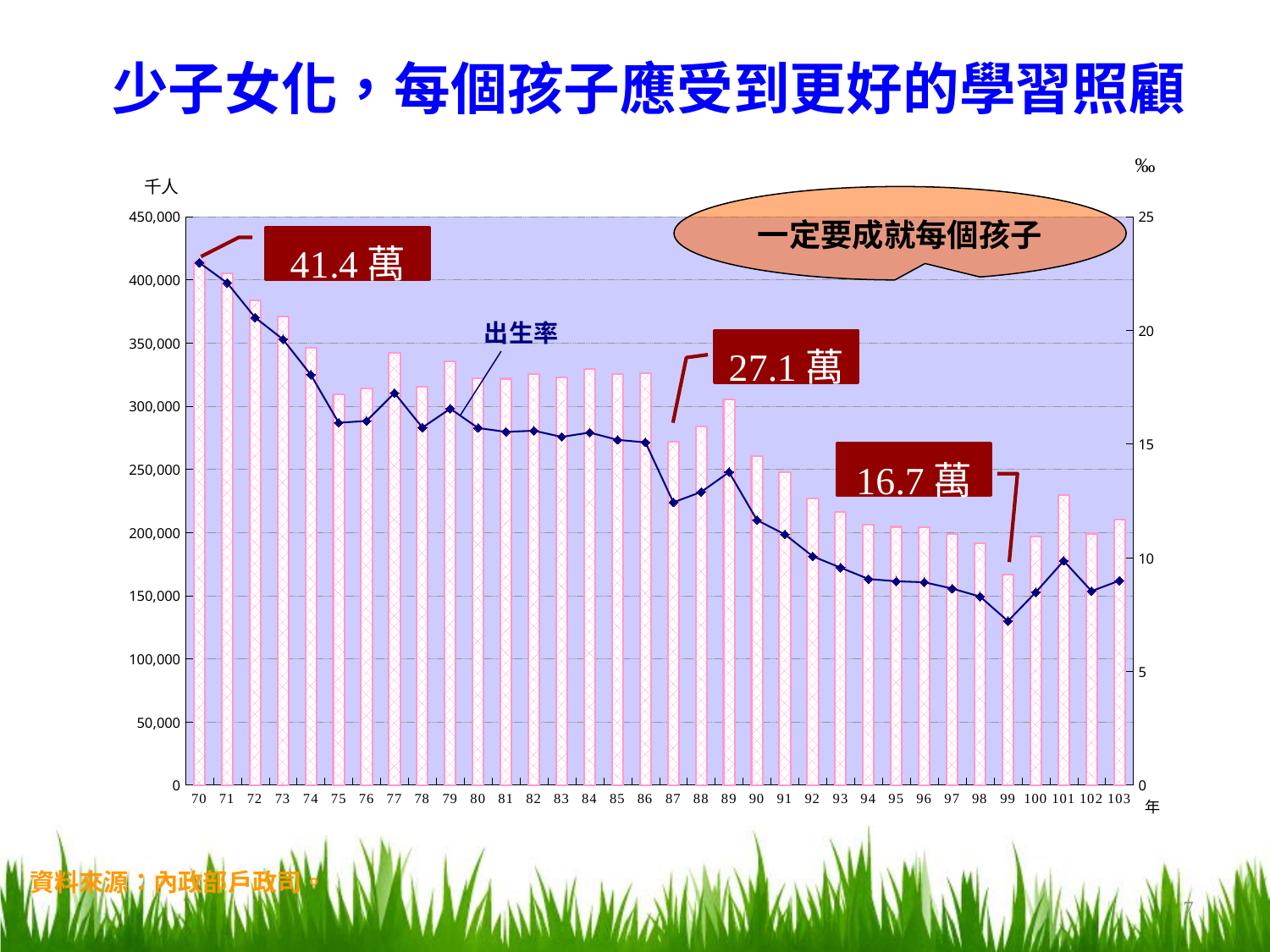
What value is annotated for year 87 in the chart? 27.1 萬 Which year has the shortest bar in the chart? 99 What value is annotated for year 70 in the chart? 41.4 萬 Is the 出生率 line value for year 70 greater or less than 20‰? greater What kind of chart is shown on the slide? A combined bar and line chart What is the overall trend of the 出生率 line from year 70 to year 103? Falling How many years are shown along the x axis of the chart? 34 What is the difference between the annotated values for year 70 and year 87? 14.3 萬 Is the bar value for year 99 greater or less than 200,000? less What value is annotated for year 99 in the chart? 16.7 萬 Which year has the tallest bar in the chart? 70 Which year has the taller bar, 100 or 101? 101